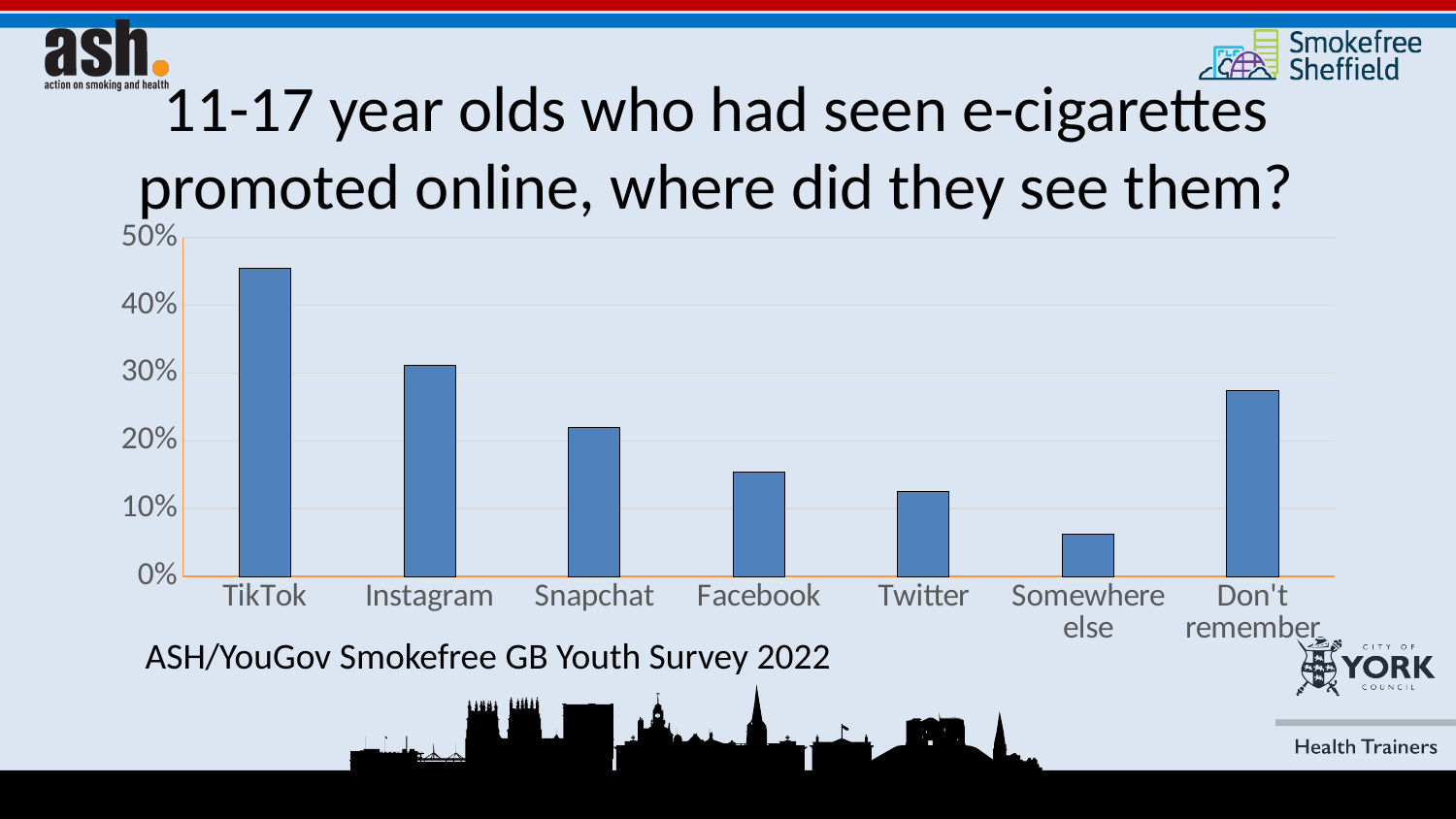
How many categories are shown on the x axis of the chart? 7 Which is larger, the value for Facebook or the value for Twitter? Facebook Which is larger, the value for Instagram or the value for Don't remember? Instagram Is the value for Don't remember greater or less than 30%? less What kind of chart is shown on the slide? Bar chart Is the value for Somewhere else greater or less than 10%? less Which category has the lowest value in the chart? Somewhere else Which category has the highest value in the chart? TikTok What survey is cited as the source of the chart data? ASH/YouGov Smokefree GB Youth Survey 2022 Is the value for TikTok greater or less than 40%? greater